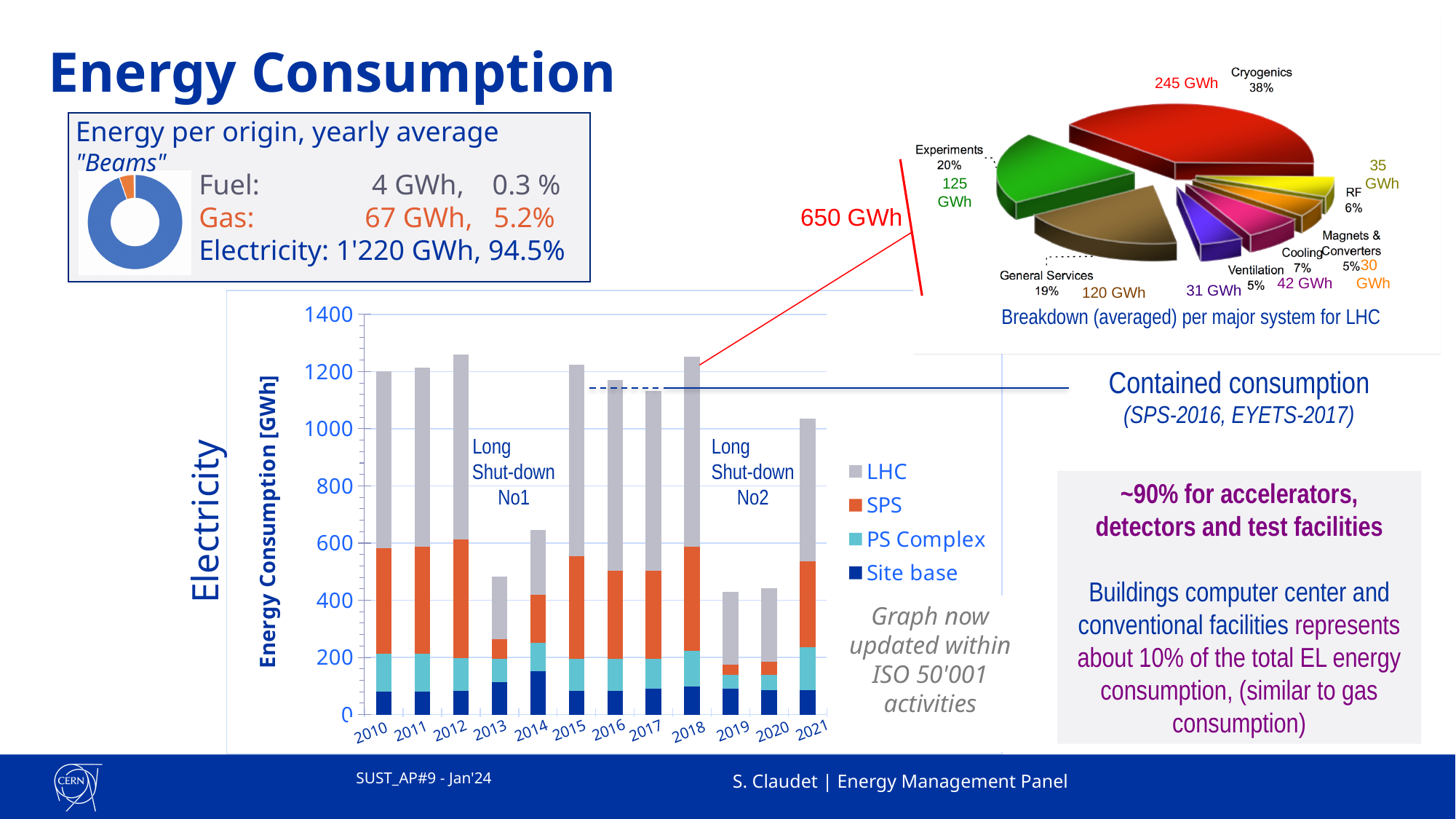
What kind of chart is the Electricity chart showing Energy Consumption [GWh] from 2010 to 2021? Stacked bar chart In the pie chart 'Breakdown (averaged) per major system for LHC', which system has the largest share? Cryogenics In the donut chart 'Energy per origin, yearly average', what is the value for Gas? 67 GWh In the pie chart 'Breakdown (averaged) per major system for LHC', which is larger, Cooling or Ventilation? Cooling In the Electricity bar chart, how many series does the legend list? 4 In the pie chart 'Breakdown (averaged) per major system for LHC', what is the value for Cryogenics? 245 GWh In the Electricity bar chart, is the total value for 2013 greater or less than 600? less In the Electricity bar chart, how many years are shown on the x axis? 12 In the donut chart 'Energy per origin, yearly average', what share does Electricity represent? 94.5% In the pie chart 'Breakdown (averaged) per major system for LHC', what share of the pie do Experiments represent? 20% In the pie chart 'Breakdown (averaged) per major system for LHC', what is the difference in GWh between Cryogenics and General Services? 125 GWh In the pie chart 'Breakdown (averaged) per major system for LHC', how many systems are shown? 7